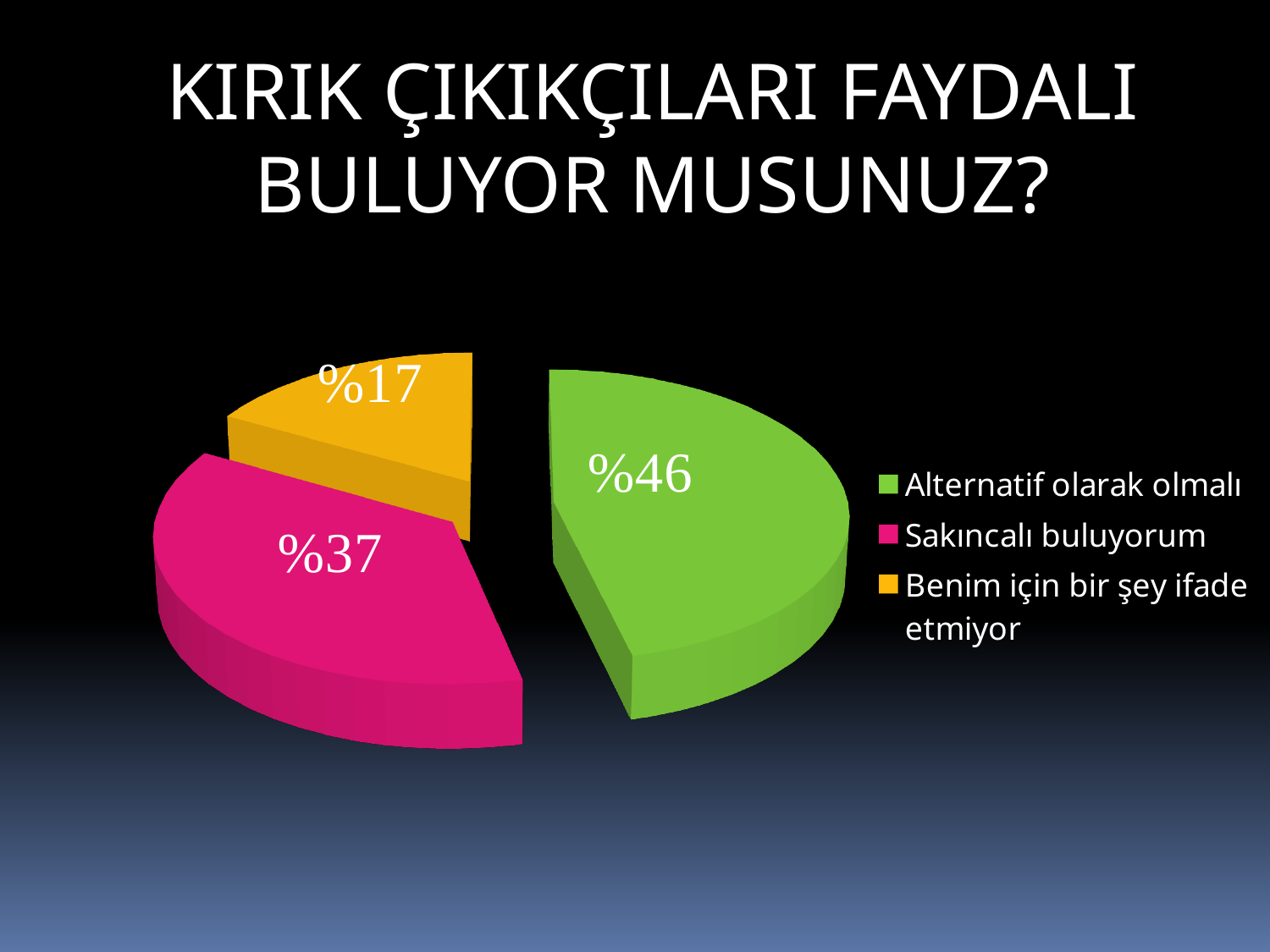
What is the value for "Alternatif olarak olmalı"? %46 What is the value for "Benim için bir şey ifade etmiyor"? %17 Which is larger, the value for "Sakıncalı buluyorum" or the value for "Benim için bir şey ifade etmiyor"? Sakıncalı buluyorum What is the difference between the values for "Sakıncalı buluyorum" and "Benim için bir şey ifade etmiyor"? %20 What is the difference between the values for "Alternatif olarak olmalı" and "Sakıncalı buluyorum"? %9 What is the title of the slide containing the chart? KIRIK ÇIKIKÇILARI FAYDALI BULUYOR MUSUNUZ? How many slices does the pie chart have? 3 What kind of chart is shown on the slide? pie chart What is the value for "Sakıncalı buluyorum"? %37 Which category has the largest share of the pie? Alternatif olarak olmalı What colour is the slice for "Sakıncalı buluyorum"? pink Which category has the smallest share of the pie? Benim için bir şey ifade etmiyor